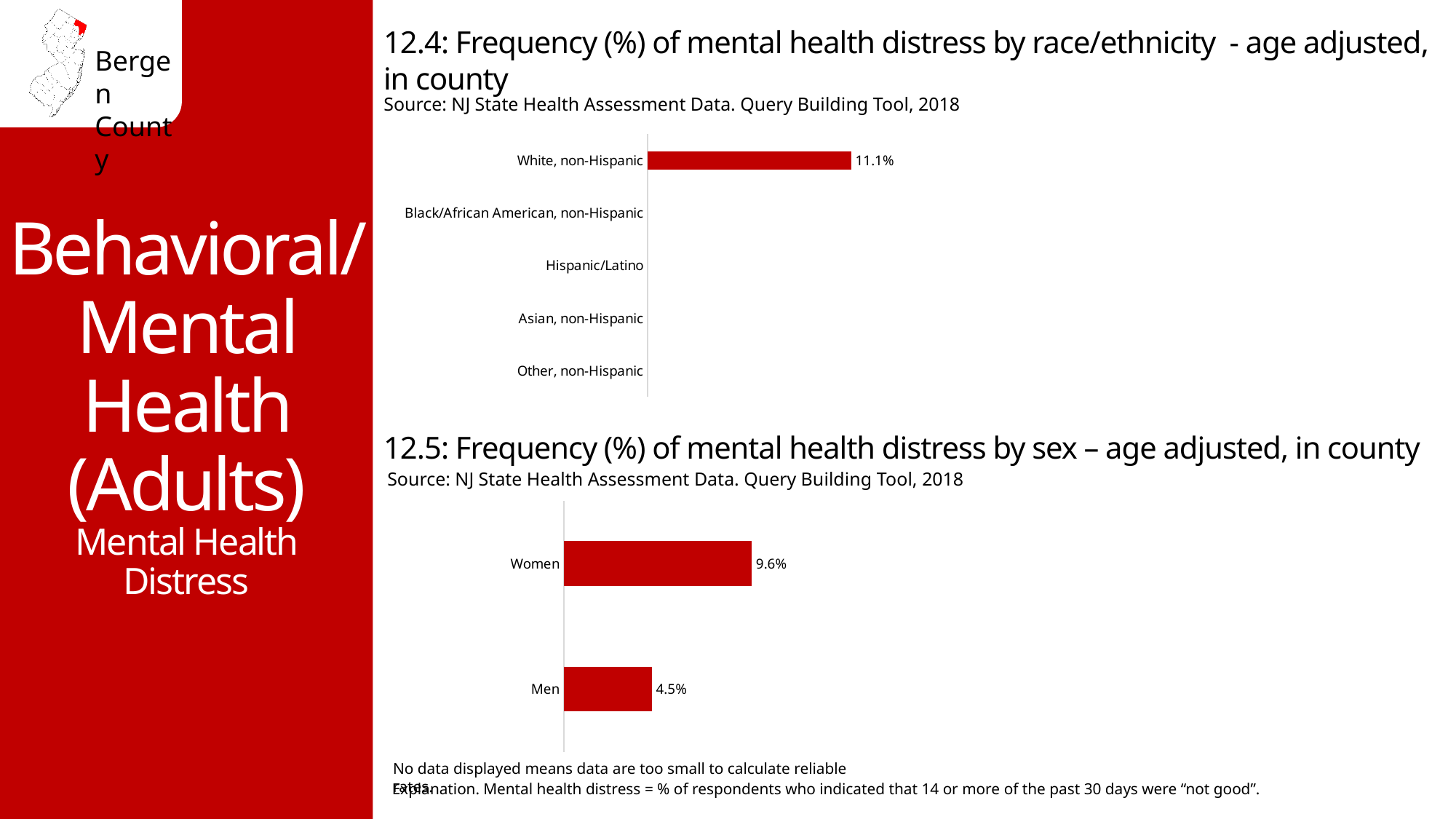
In the chart '12.5: Frequency (%) of mental health distress by sex – age adjusted, in county', how many categories are shown? 2 In the chart '12.5: Frequency (%) of mental health distress by sex – age adjusted, in county', which category has the lower value? Men What kind of chart is '12.4: Frequency (%) of mental health distress by race/ethnicity - age adjusted, in county'? Bar chart In the chart '12.5: Frequency (%) of mental health distress by sex – age adjusted, in county', what is the value for Women? 9.6% In the chart '12.4: Frequency (%) of mental health distress by race/ethnicity - age adjusted, in county', what is the value for White, non-Hispanic? 11.1% What kind of chart is '12.5: Frequency (%) of mental health distress by sex – age adjusted, in county'? Bar chart In the chart '12.5: Frequency (%) of mental health distress by sex – age adjusted, in county', is the value for Women larger or smaller than the value for Men? Larger In the chart '12.4: Frequency (%) of mental health distress by race/ethnicity - age adjusted, in county', which category is the only one with a bar displayed? White, non-Hispanic In the chart '12.5: Frequency (%) of mental health distress by sex – age adjusted, in county', what is the difference between the values for Women and Men? 5.1% In the chart '12.5: Frequency (%) of mental health distress by sex – age adjusted, in county', what is the value for Men? 4.5% In the chart '12.5: Frequency (%) of mental health distress by sex – age adjusted, in county', which category has the higher value? Women In the chart '12.4: Frequency (%) of mental health distress by race/ethnicity - age adjusted, in county', how many race/ethnicity categories are listed on the axis? 5